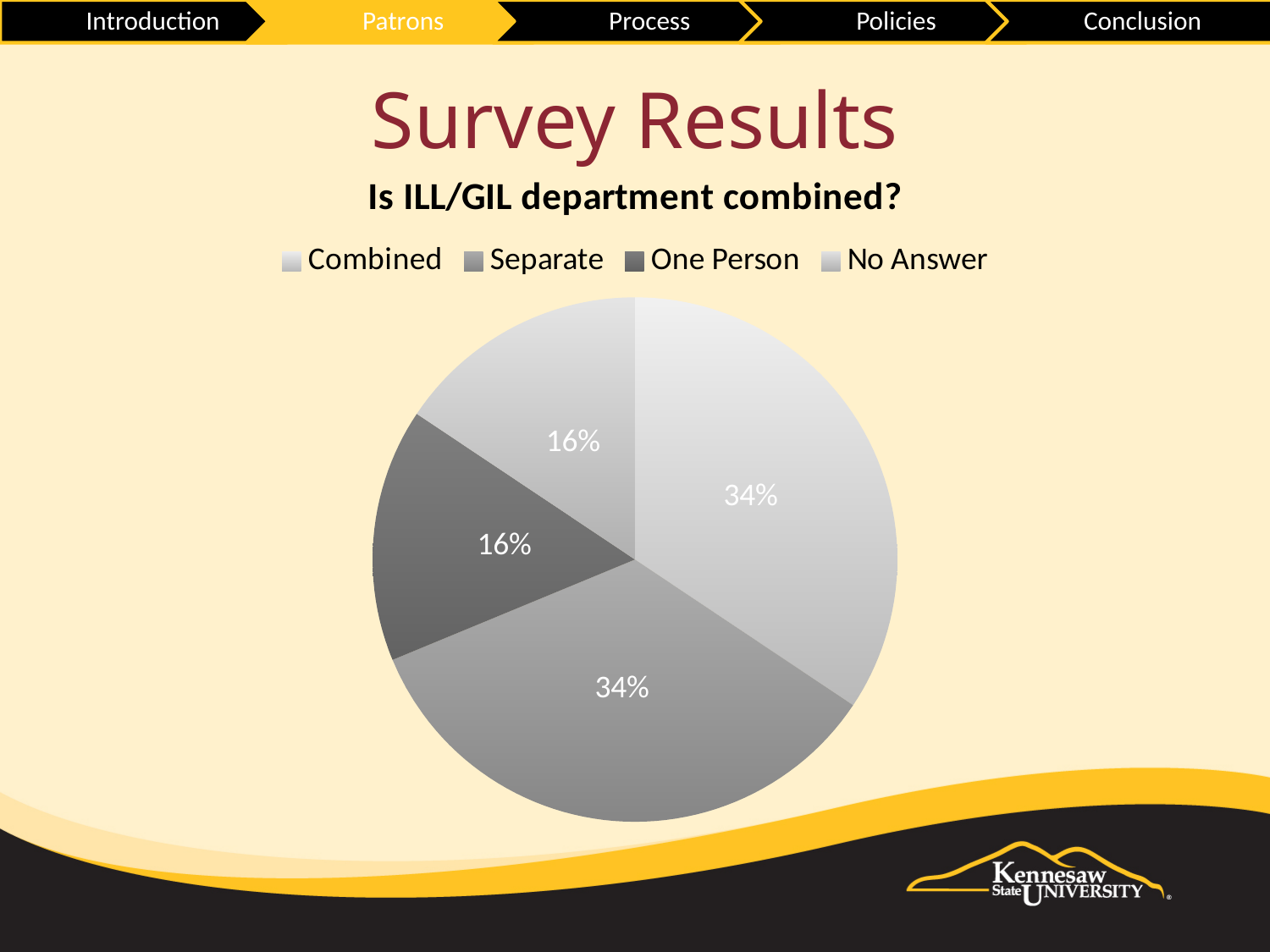
How many categories does the legend list? 4 What share of the pie is the No Answer slice? 16% What is the title of the chart? Is ILL/GIL department combined? Which is larger, the Combined slice or the One Person slice? Combined What share of the pie is the One Person slice? 16% What share of the pie is the Combined slice? 34% How many slices does the pie chart have? 4 What kind of chart is shown on the slide? pie chart What is the combined share of the Combined and Separate slices? 68% What is the difference in percentage points between the Separate slice and the No Answer slice? 18 Which is larger, the No Answer slice or the Separate slice? Separate